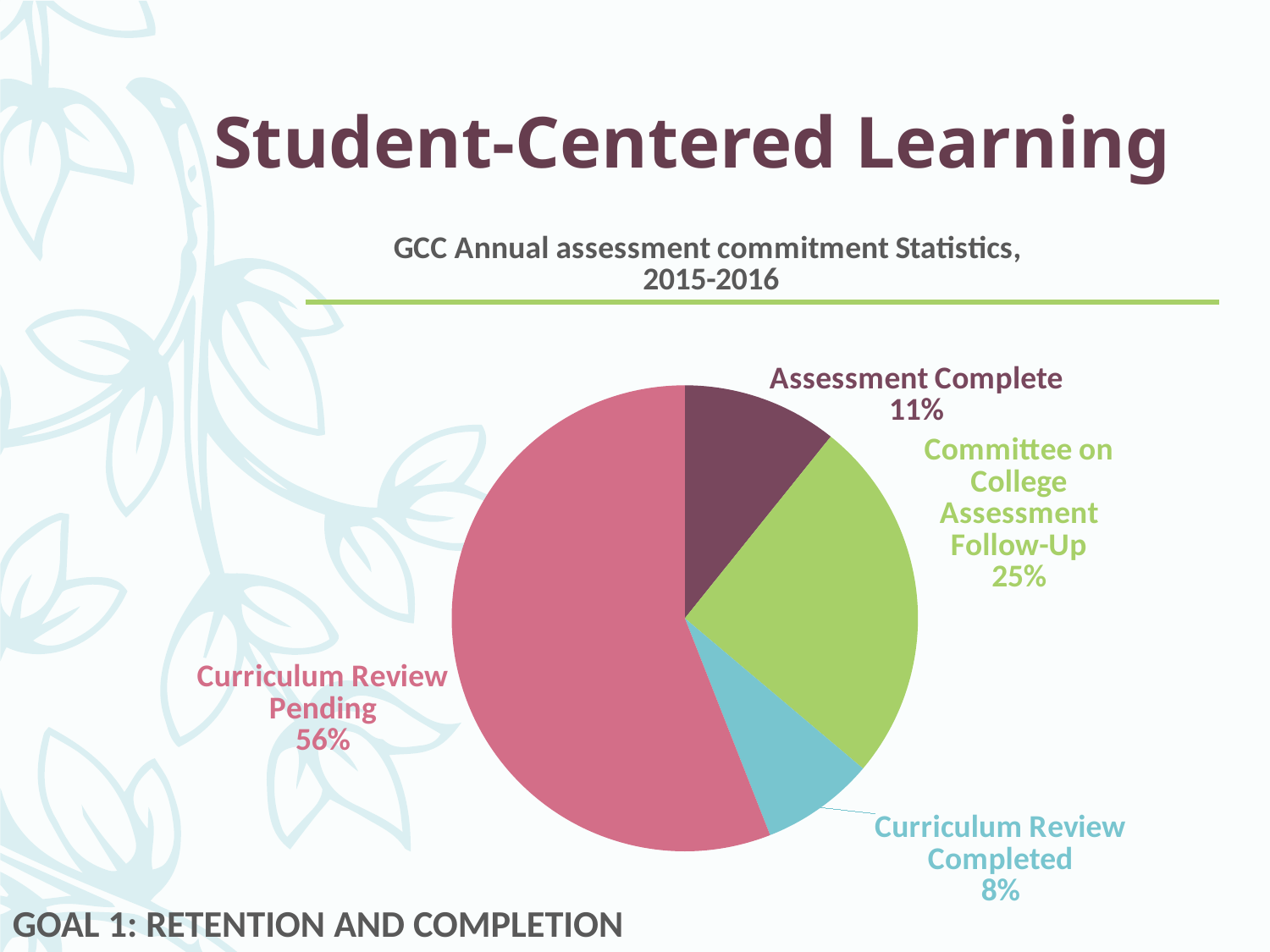
Which is larger, Assessment Complete or Committee on College Assessment Follow-Up? Committee on College Assessment Follow-Up What is the value for Curriculum Review Completed? 8% What is the difference between Curriculum Review Pending and Committee on College Assessment Follow-Up? 31% What is the title of the chart? GCC Annual assessment commitment Statistics, 2015-2016 What is the value for Assessment Complete? 11% What is the value for Committee on College Assessment Follow-Up? 25% What share of the pie does Curriculum Review Pending represent? 56% Which category has the smallest slice of the pie? Curriculum Review Completed What is the difference between Assessment Complete and Curriculum Review Completed? 3% What kind of chart is shown on the slide? Pie chart How many categories are shown in the pie chart? 4 Which category has the largest slice of the pie? Curriculum Review Pending